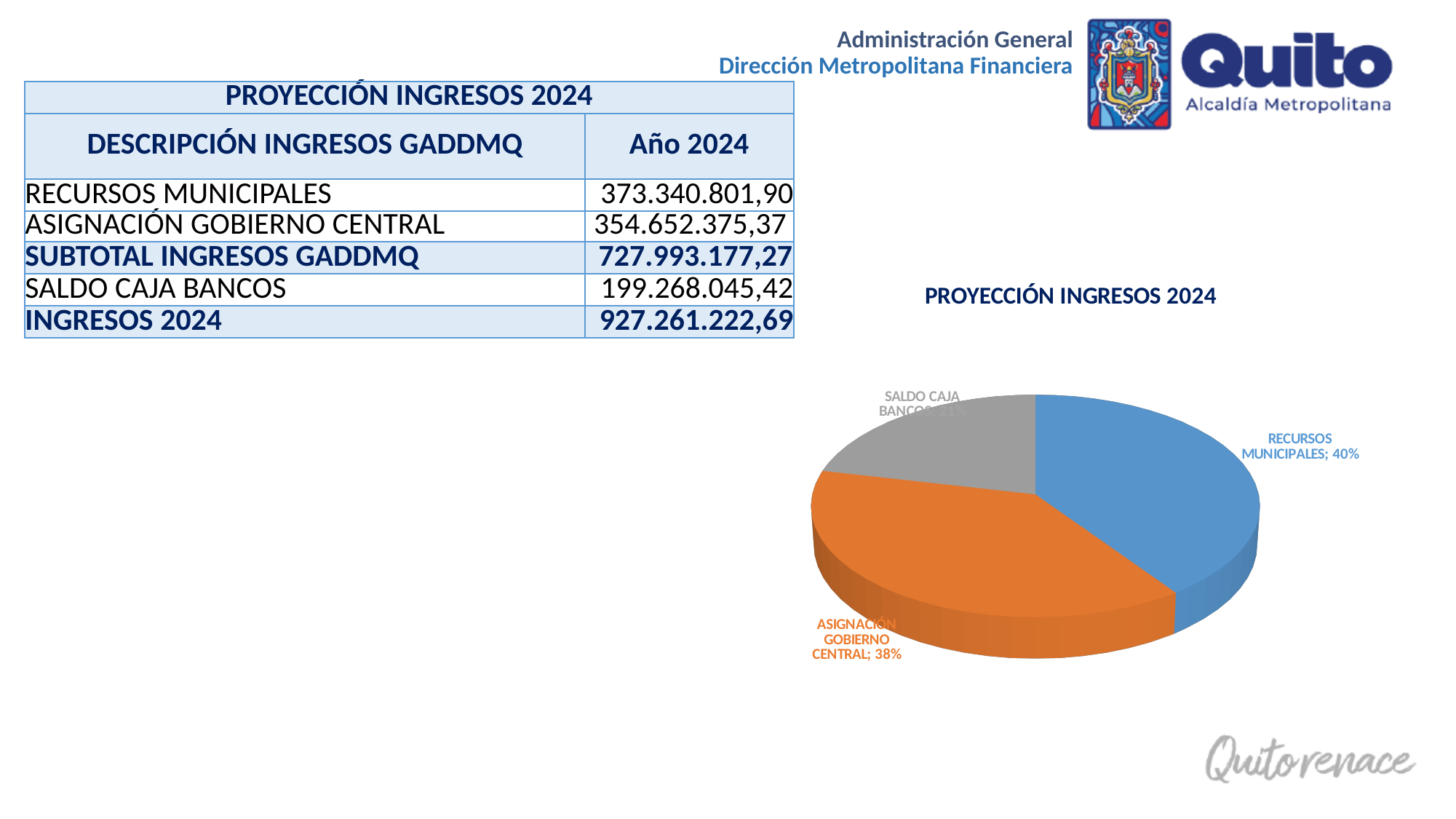
Which slice of the pie chart is the largest? RECURSOS MUNICIPALES What share of the pie chart is SALDO CAJA BANCOS? 21% Which slice of the pie chart is the smallest? SALDO CAJA BANCOS In the pie chart, which is larger: ASIGNACIÓN GOBIERNO CENTRAL or SALDO CAJA BANCOS? ASIGNACIÓN GOBIERNO CENTRAL What colour is the SALDO CAJA BANCOS slice in the pie chart? grey In the pie chart, what is the difference in percentage points between RECURSOS MUNICIPALES and ASIGNACIÓN GOBIERNO CENTRAL? 2 What share of the pie chart is RECURSOS MUNICIPALES? 40% What share of the pie chart is ASIGNACIÓN GOBIERNO CENTRAL? 38% What kind of chart is shown on the slide? pie chart How many slices does the pie chart have? 3 In the pie chart, what is the difference in percentage points between RECURSOS MUNICIPALES and SALDO CAJA BANCOS? 19 What is the title of the pie chart? PROYECCIÓN INGRESOS 2024